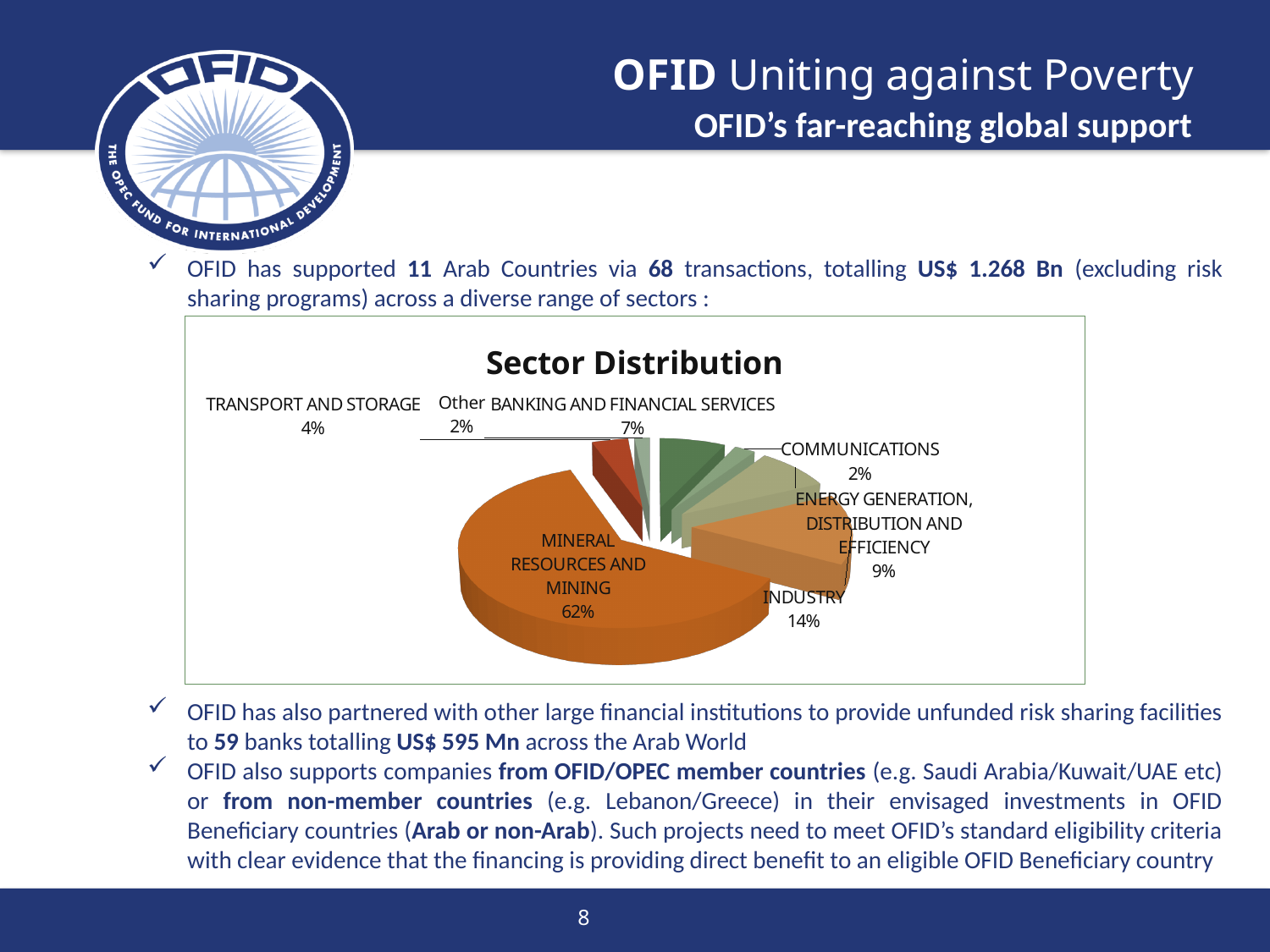
What percentage is shown for Energy Generation, Distribution and Efficiency? 9% What percentage is shown for Transport and Storage? 4% What type of chart is shown on the slide? Pie chart What percentage is shown for Banking and Financial Services? 7% What percentage is shown for Industry? 14% Which sector has the largest share of the pie? Mineral Resources and Mining What percentage is shown for Communications? 2% Which has a larger share, Banking and Financial Services or Transport and Storage? Banking and Financial Services What is the difference in percentage points between Industry and Energy Generation, Distribution and Efficiency? 5 How many sectors (slices) are shown in the pie chart? 7 What share of the pie does Mineral Resources and Mining account for? 62% What is the title of the chart? Sector Distribution